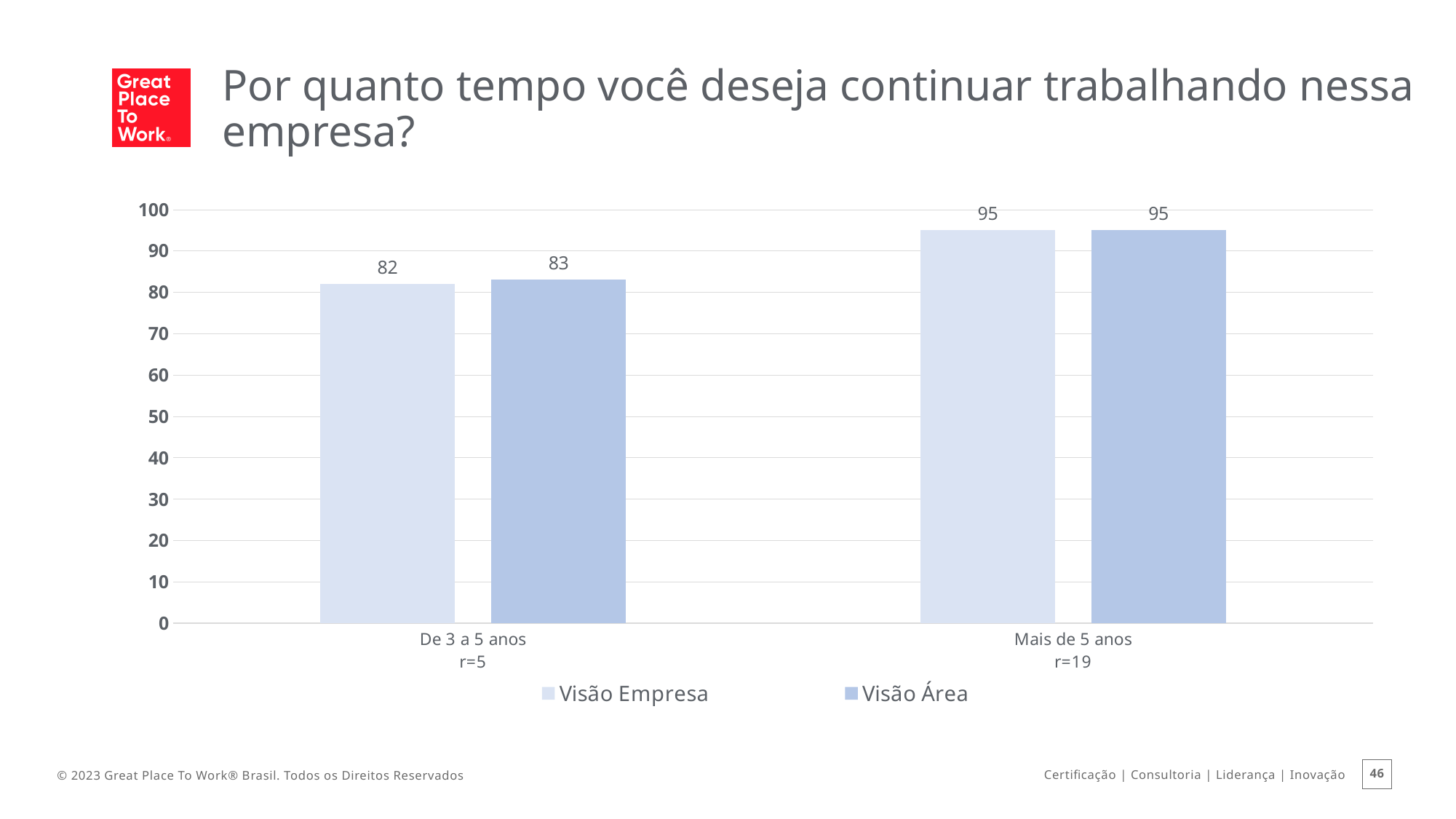
How many categories are shown on the x axis? 2 What kind of chart is shown on the slide? bar chart What is the Visão Área value for 'Mais de 5 anos'? 95 What is the Visão Empresa value for 'De 3 a 5 anos'? 82 How many series does the legend list? 2 What is the Visão Área value for 'De 3 a 5 anos'? 83 Is the Visão Empresa value for 'De 3 a 5 anos' greater or less than 90? less Which category has the highest Visão Empresa value? Mais de 5 anos What is the difference between the Visão Área and Visão Empresa values for 'De 3 a 5 anos'? 1 Which category has the lowest Visão Área value? De 3 a 5 anos What is the difference between the Visão Área values for 'Mais de 5 anos' and 'De 3 a 5 anos'? 12 What is the Visão Empresa value for 'Mais de 5 anos'? 95